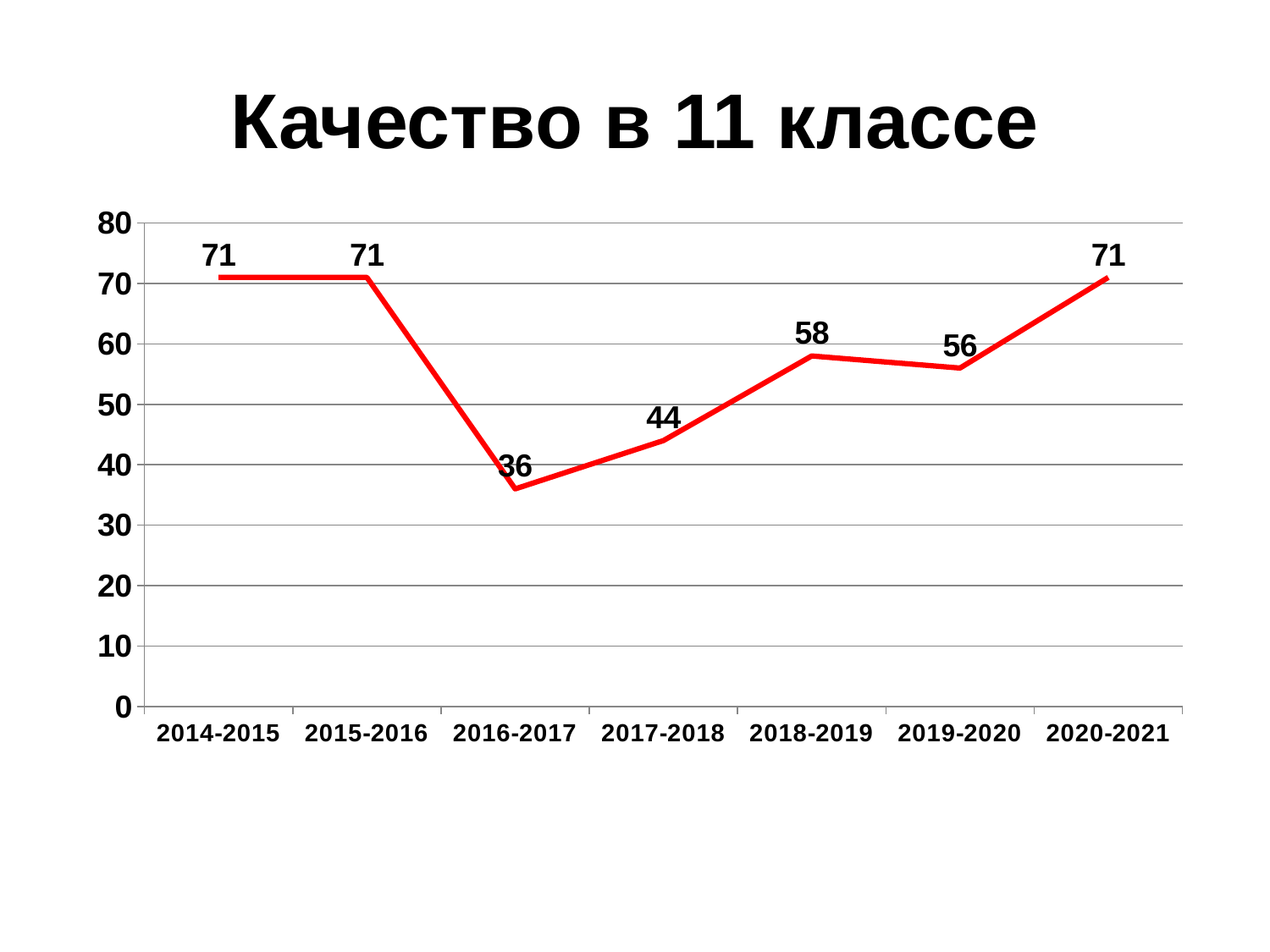
What is the value for 2017-2018? 44 What is the value for 2016-2017? 36 What kind of chart is shown on the slide? line chart Is the value for 2016-2017 greater or less than 40? less What is the title of the chart? Качество в 11 классе What is the value for 2019-2020? 56 What is the difference between the values for 2018-2019 and 2017-2018? 14 How many school years are plotted on the chart? 7 What is the difference between the values for 2015-2016 and 2016-2017? 35 What is the value for 2018-2019? 58 Which is larger, the value for 2017-2018 or the value for 2019-2020? 2019-2020 Which year has the lowest value? 2016-2017